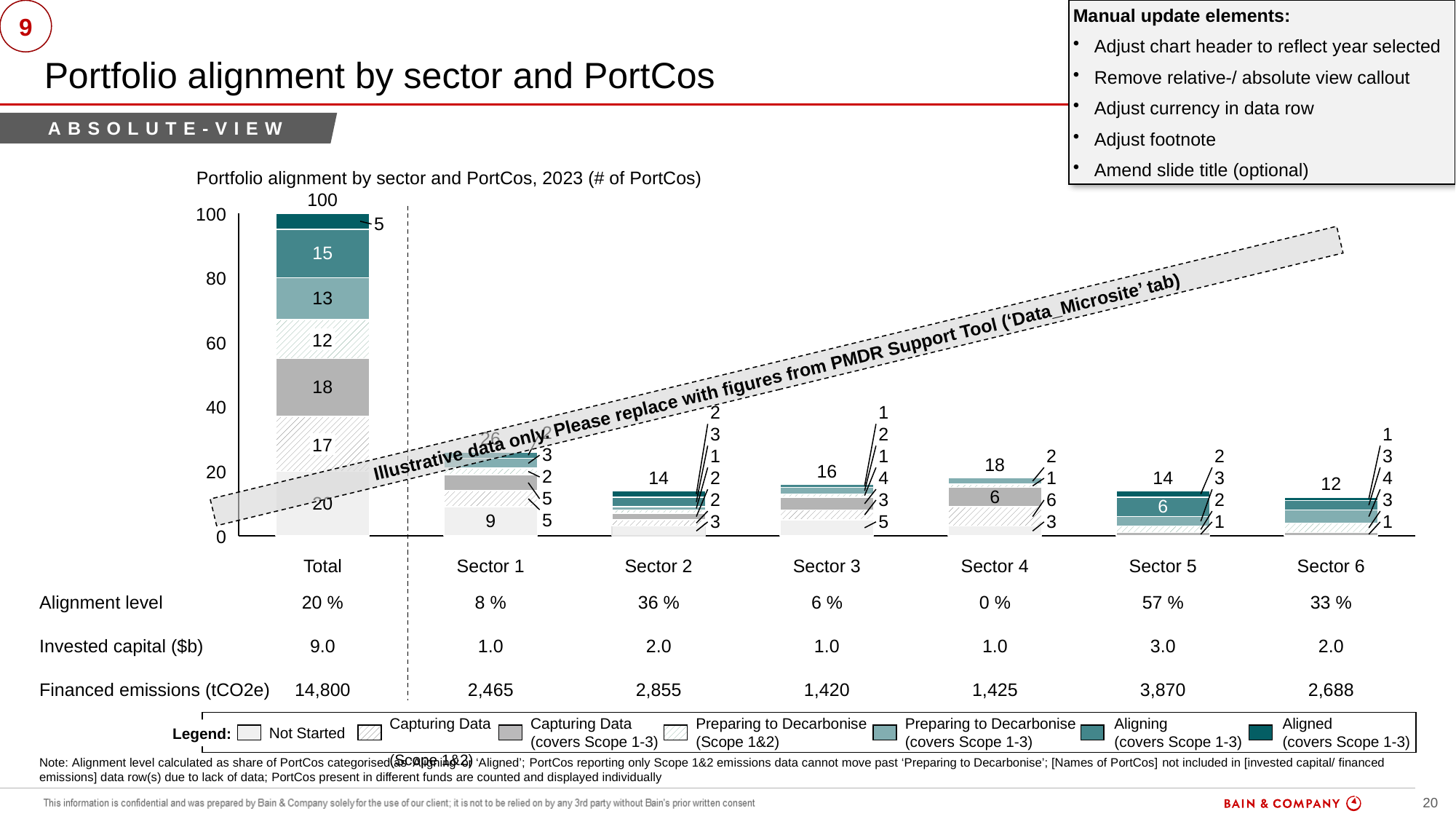
In the Total bar, how many PortCos are in the Aligning (covers Scope 1-3) segment? 15 What is the total number of PortCos shown for Sector 6? 12 What is the difference between the total PortCos for Sector 3 and Sector 6? 4 What is the total number of PortCos shown for Sector 4? 18 How many series does the chart legend list? 7 In the Total bar, how many PortCos are in the Not Started segment? 20 In the Total bar, how many PortCos are in the Aligned (covers Scope 1-3) segment? 5 How many categories are shown along the x axis of the chart? 7 Is the total number of PortCos for Sector 2 greater or less than 20? less What kind of chart is shown on the slide? Stacked bar chart What is the total number of PortCos shown for the Total bar? 100 Which has more PortCos in total, Sector 4 or Sector 6? Sector 4